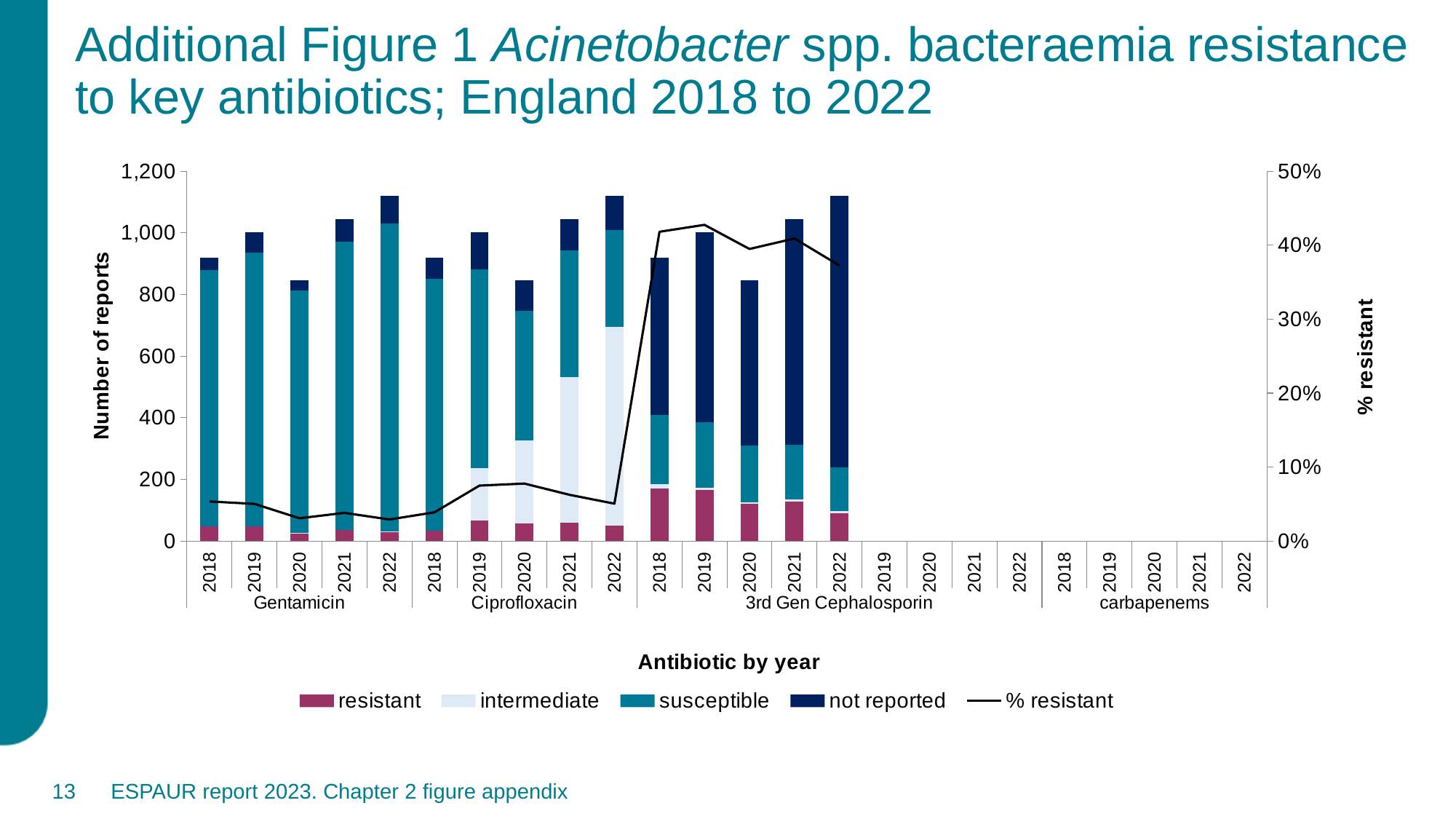
Is the total number of reports for Gentamicin in 2020 greater or less than 1,000? less Is the total number of reports for Gentamicin in 2022 greater or less than 1,000? greater Is the % resistant for Gentamicin in 2018 greater or less than 10%? less What kind of chart is shown on the slide? bar chart with a line How many bars are plotted for Gentamicin? 5 What is the title of the left vertical axis? Number of reports How many antibiotic groups are labelled on the x axis? 4 Which antibiotic group has the highest % resistant values? 3rd Gen Cephalosporin Which is larger, the % resistant for 3rd Gen Cephalosporin in 2018 or for Gentamicin in 2018? 3rd Gen Cephalosporin in 2018 How many series does the legend list? 5